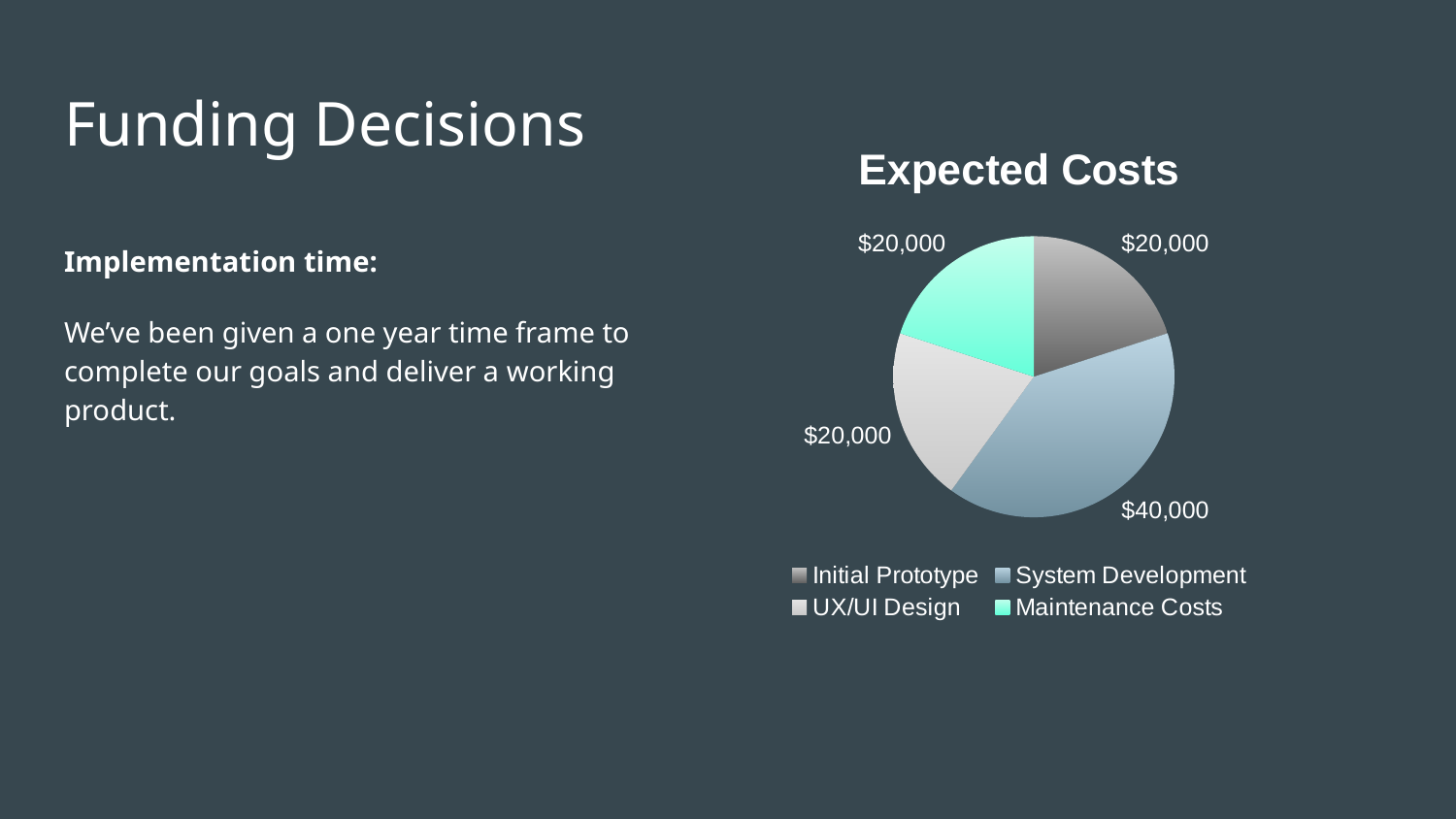
What is the title of the chart? Expected Costs What share of the total expected costs does Maintenance Costs represent? 20% What share of the total expected costs does System Development represent? 40% What is the difference between the System Development cost and the UX/UI Design cost? $20,000 How many categories does the legend list? 4 What is the expected cost for Maintenance Costs? $20,000 What is the total of all expected costs shown in the pie chart? $100,000 What is the expected cost for System Development? $40,000 What is the expected cost for Initial Prototype? $20,000 Which category has the largest expected cost? System Development What type of chart is shown on the slide? pie chart Which is larger, the cost for System Development or the cost for Initial Prototype? System Development